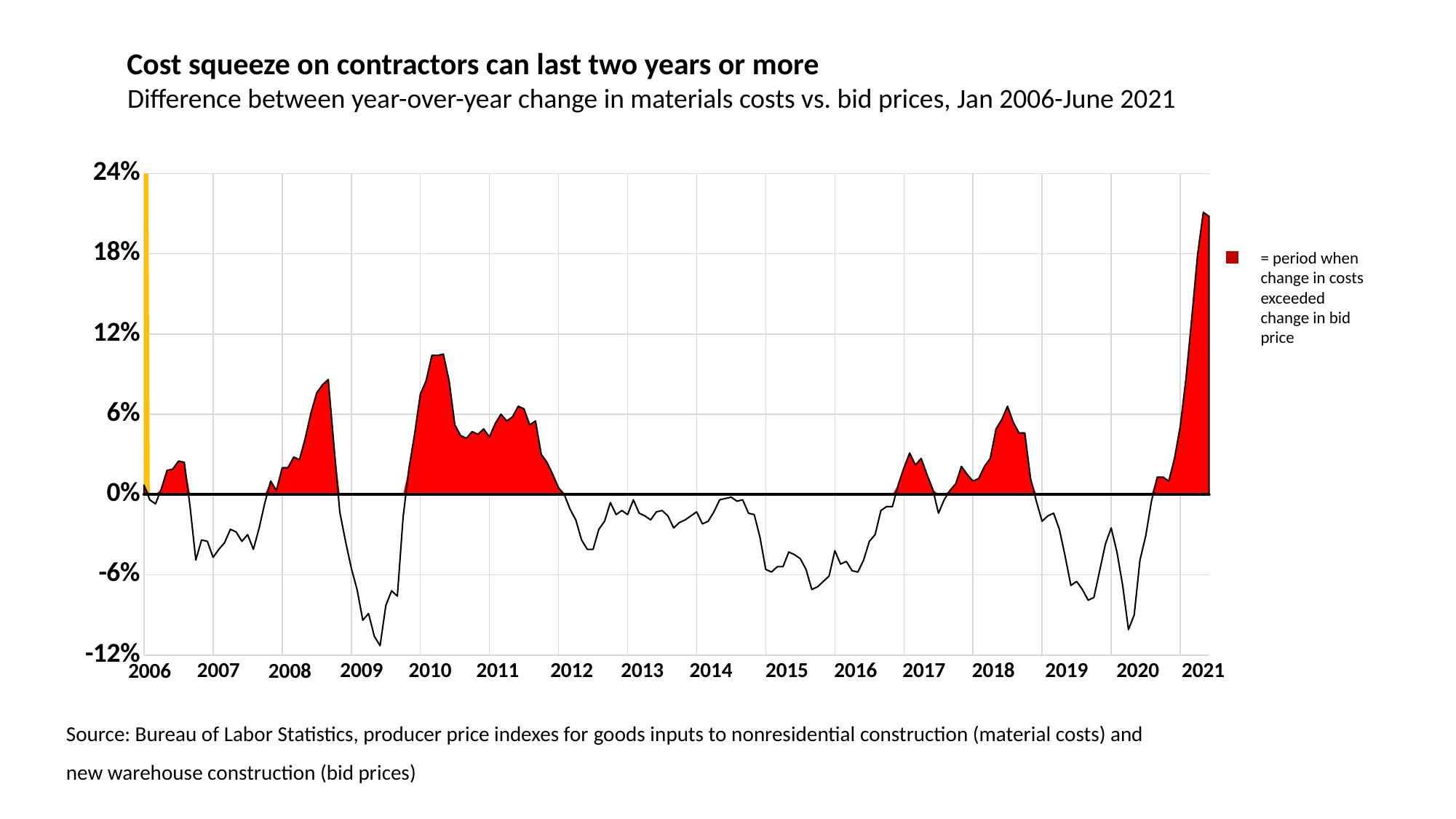
Is the peak value in 2010 greater or less than 12%? less Is the peak value in 2021 greater or less than 18%? greater What is the title of the chart? Cost squeeze on contractors can last two years or more Is the lowest value in 2009 greater or less than -6%? less Which is larger, the peak value in 2021 or the peak value in 2018? 2021 Does the line rise or fall from the start of 2020 to mid-2021? rise How many year labels are shown on the x axis? 16 What kind of chart is shown on the slide? line chart In which year does the line reach its lowest value? 2009 What does the red shading in the chart indicate, according to the legend? period when change in costs exceeded change in bid price In which year does the line reach its highest value? 2021